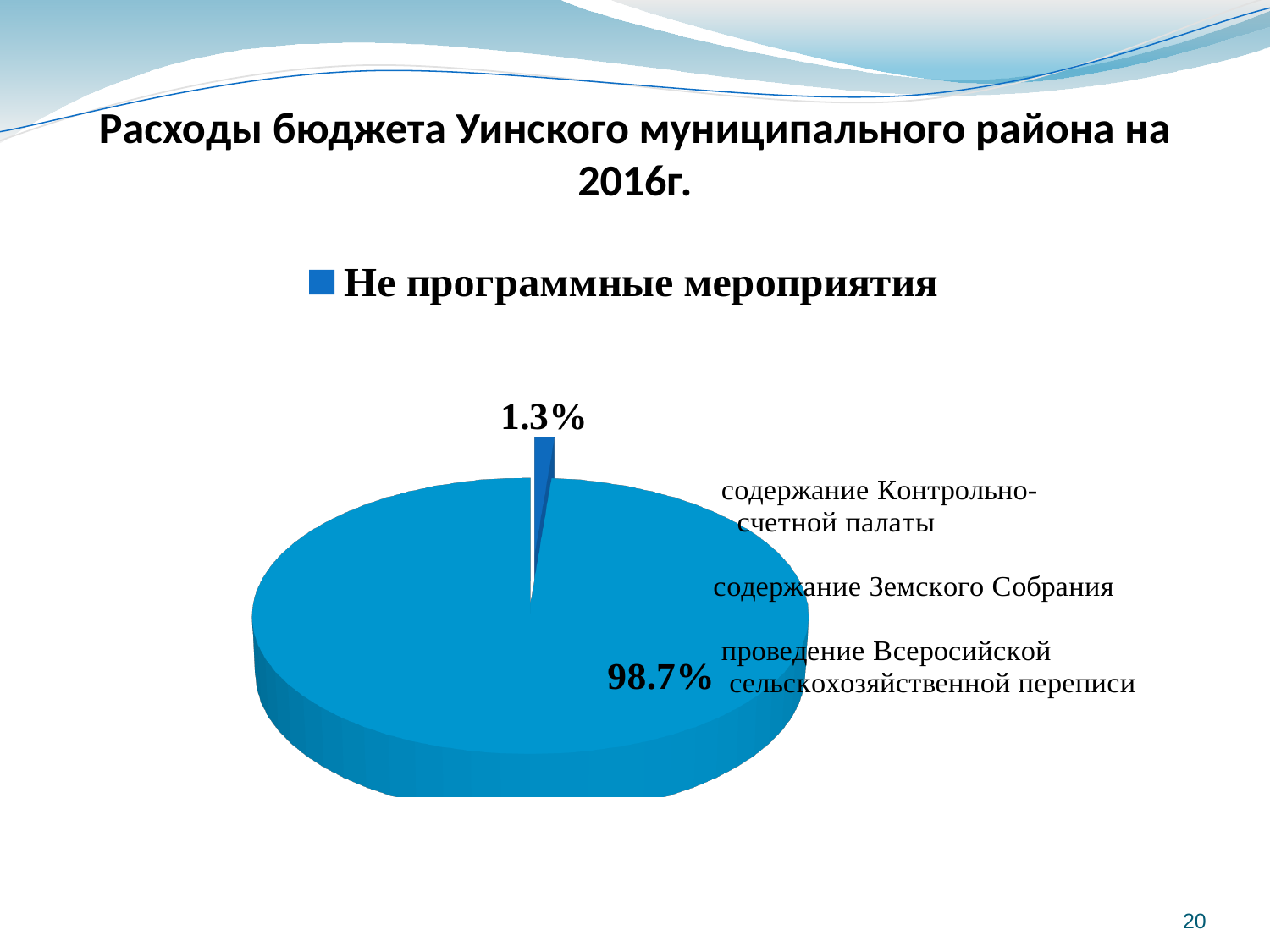
How many series does the chart legend list? 1 What is the total of the two percentage labels shown on the pie chart? 100% Is the value of the smallest slice greater or less than 10%? less What percentage is shown on the smallest slice of the pie chart? 1.3% How many percentage data labels are printed on the pie chart? 2 Is the value of the largest slice greater or less than 90%? greater What kind of chart is shown on the slide? pie chart What percentage is shown on the largest slice of the pie chart? 98.7% Which is larger, the slice labelled 98.7% or the slice labelled 1.3%? 98.7% How many category labels are listed to the right of the pie chart? 3 What is the difference between the two percentage labels shown on the pie chart? 97.4%